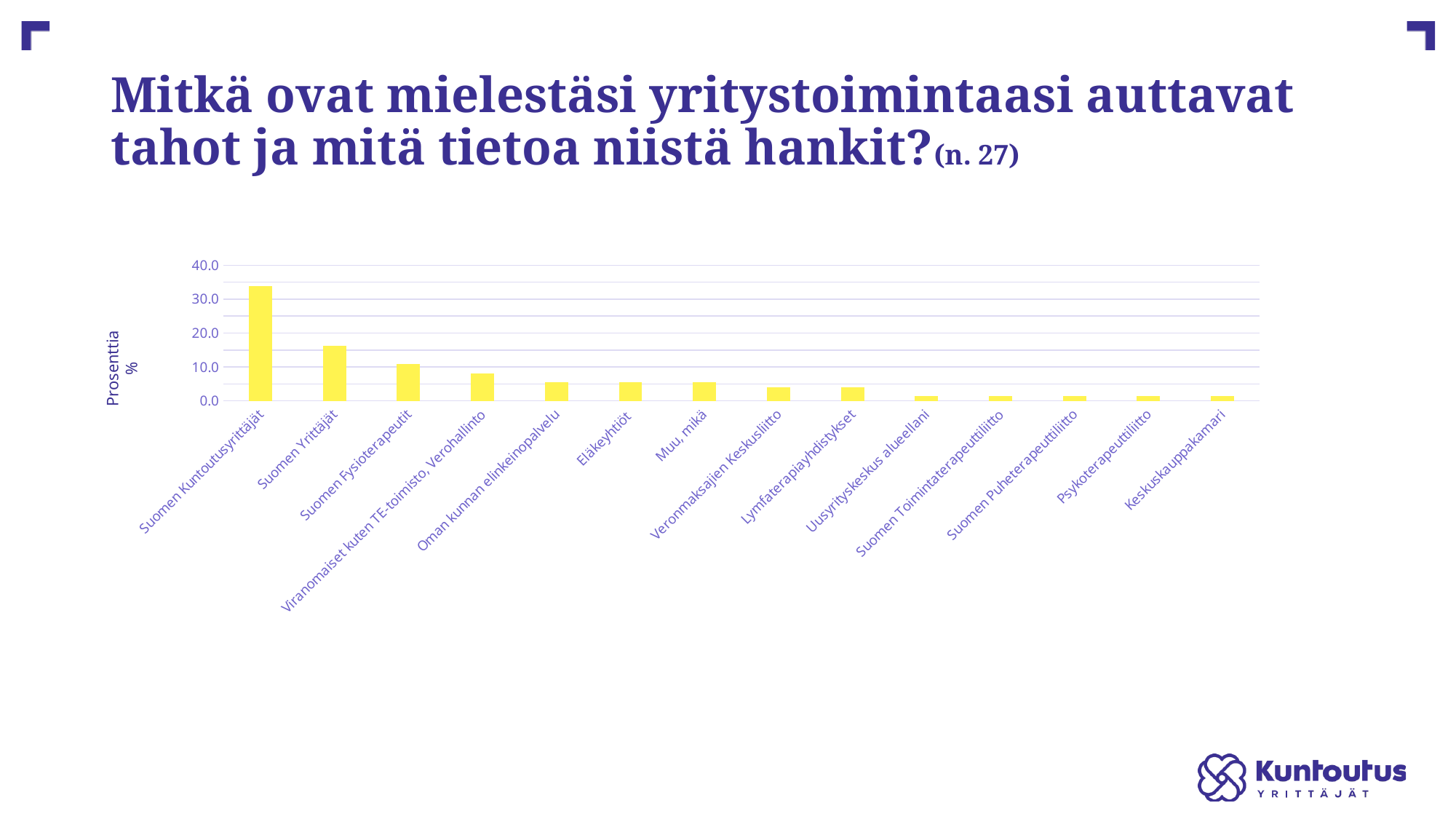
Is the value for Keskuskauppakamari greater or less than 10.0? less Which has a larger value, Suomen Kuntoutusyrittäjät or Eläkeyhtiöt? Suomen Kuntoutusyrittäjät Is the value for Suomen Kuntoutusyrittäjät greater or less than 30.0? greater Which has a larger value, Suomen Yrittäjät or Suomen Fysioterapeutit? Suomen Yrittäjät What is the label on the vertical axis of the chart? Prosenttia % What kind of chart is shown on the slide? bar chart Which category has the highest value in the chart? Suomen Kuntoutusyrittäjät Is the value for Suomen Yrittäjät greater or less than 10.0? greater How many categories are plotted in the chart? 14 Do the bar values rise or fall from left to right along the x axis? fall